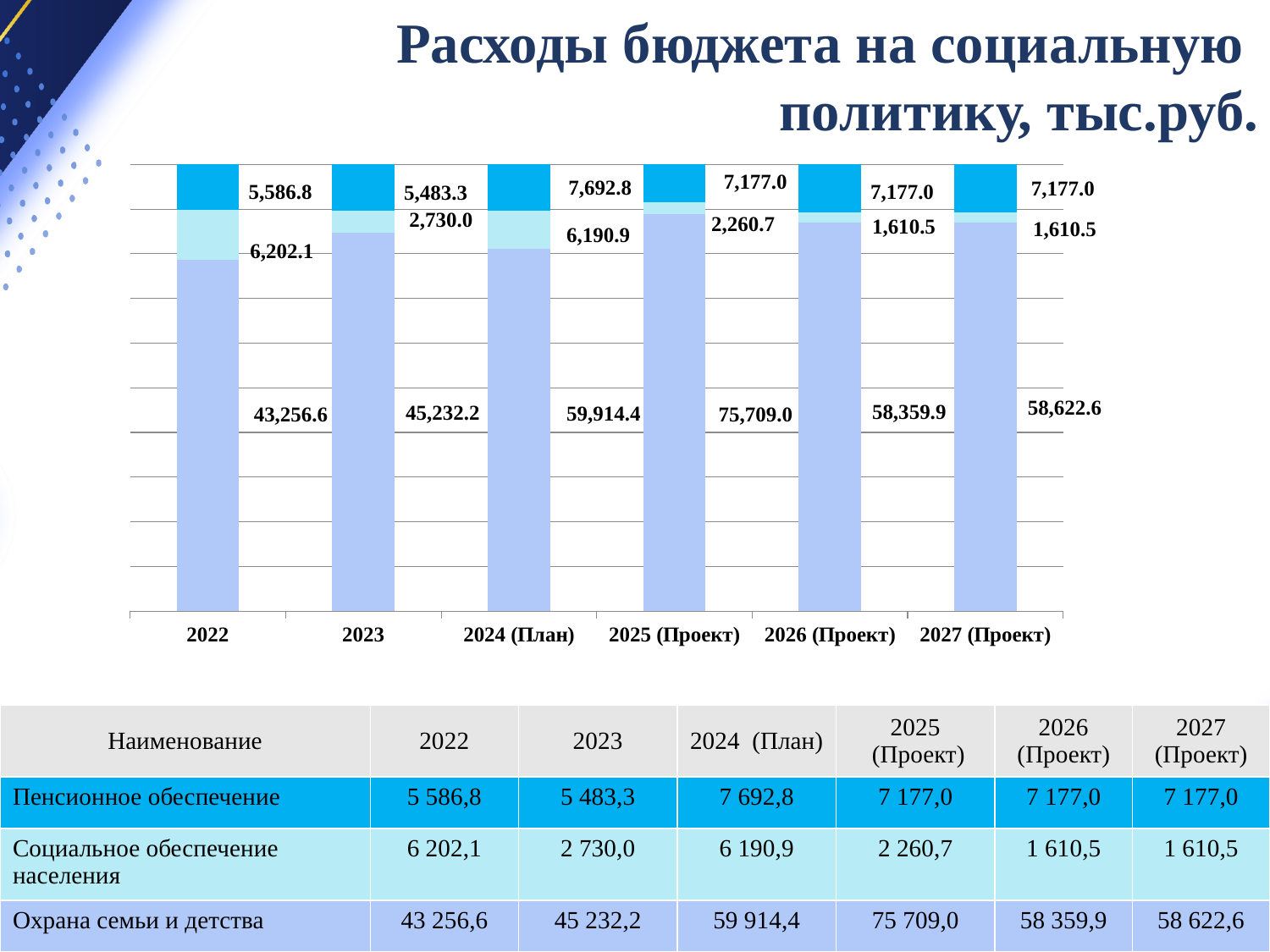
What is the difference between the Пенсионное обеспечение values for 2024 (План) and 2022? 2,106.0 Which is larger: the Пенсионное обеспечение value for 2024 (План) or for 2023? 2024 (План) What is the difference between the Охрана семьи и детства values for 2025 (Проект) and 2024 (План)? 15,794.6 What is the value for Охрана семьи и детства in 2025 (Проект) on the chart? 75,709.0 What kind of chart is shown on the slide? stacked bar chart Does the Социальное обеспечение населения value rise or fall from 2024 (План) to 2027 (Проект)? fall What is the total of the stacked bar for 2027 (Проект)? 67,410.1 In which year is the Охрана семьи и детства segment the largest? 2025 (Проект) In which year is the Охрана семьи и детства segment the smallest? 2022 What is the total of the stacked bar for 2022? 55,045.5 How many year categories are shown along the x axis of the chart? 6 What is the value for Социальное обеспечение населения in 2023 on the chart? 2,730.0